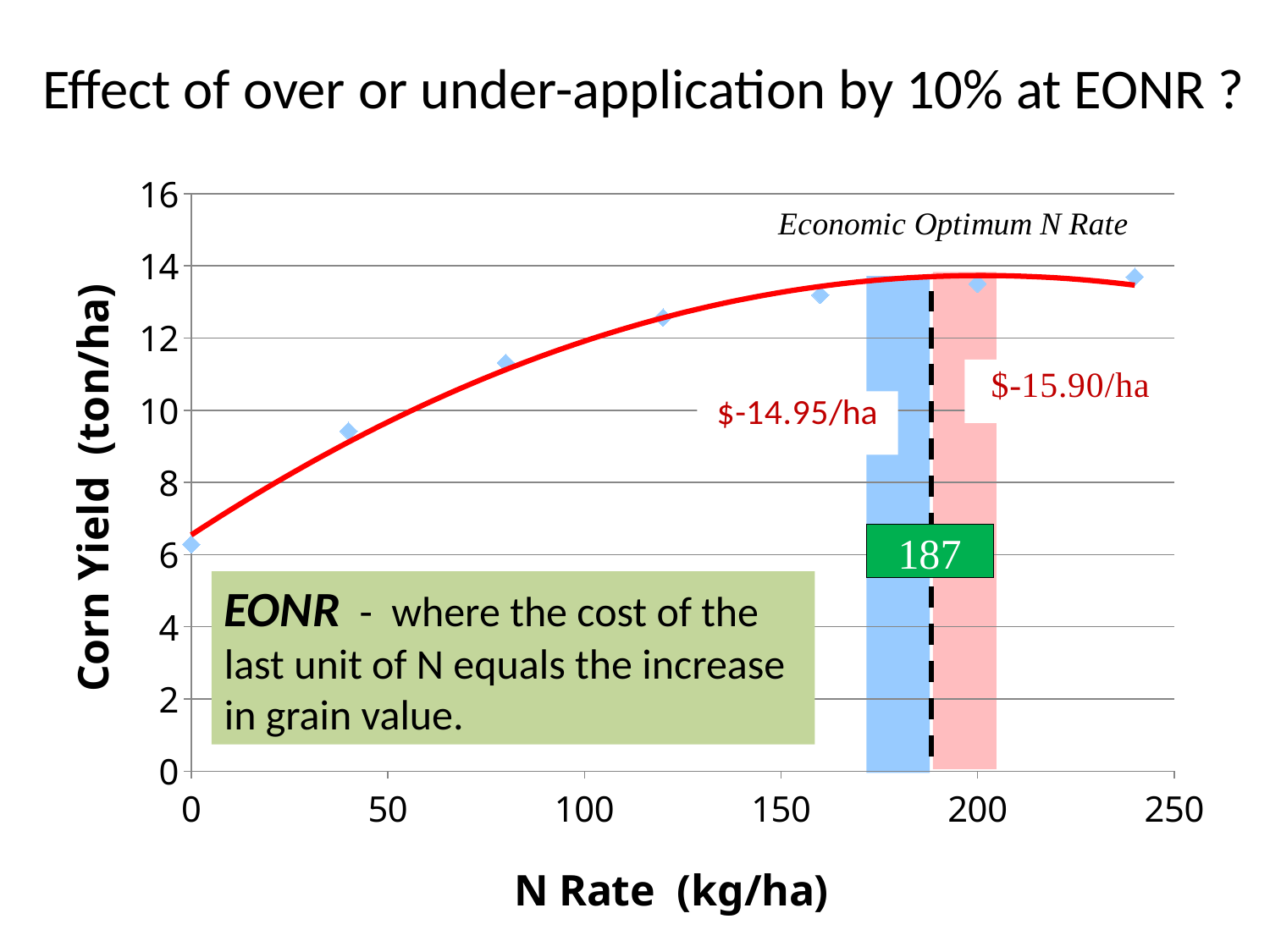
Is the corn yield at an N rate of 40 greater or less than 10? less What is the label of the y axis? Corn Yield (ton/ha) What cost per hectare is shown for over-application by 10% (the pink band)? $-15.90/ha Is the corn yield at an N rate of 0 greater or less than 8? less What kind of chart is shown on the slide? scatter chart with a fitted curve Is the corn yield at an N rate of 160 greater or less than 12? greater What is the label of the x axis? N Rate (kg/ha) Does corn yield generally rise or fall as N rate increases from 0 to 160? rise Which N rate has the lowest corn yield? 0 What N rate value is marked as the Economic Optimum N Rate on the chart? 187 What cost per hectare is shown for under-application by 10% (the blue band)? $-14.95/ha How many data points are plotted on the chart? 7